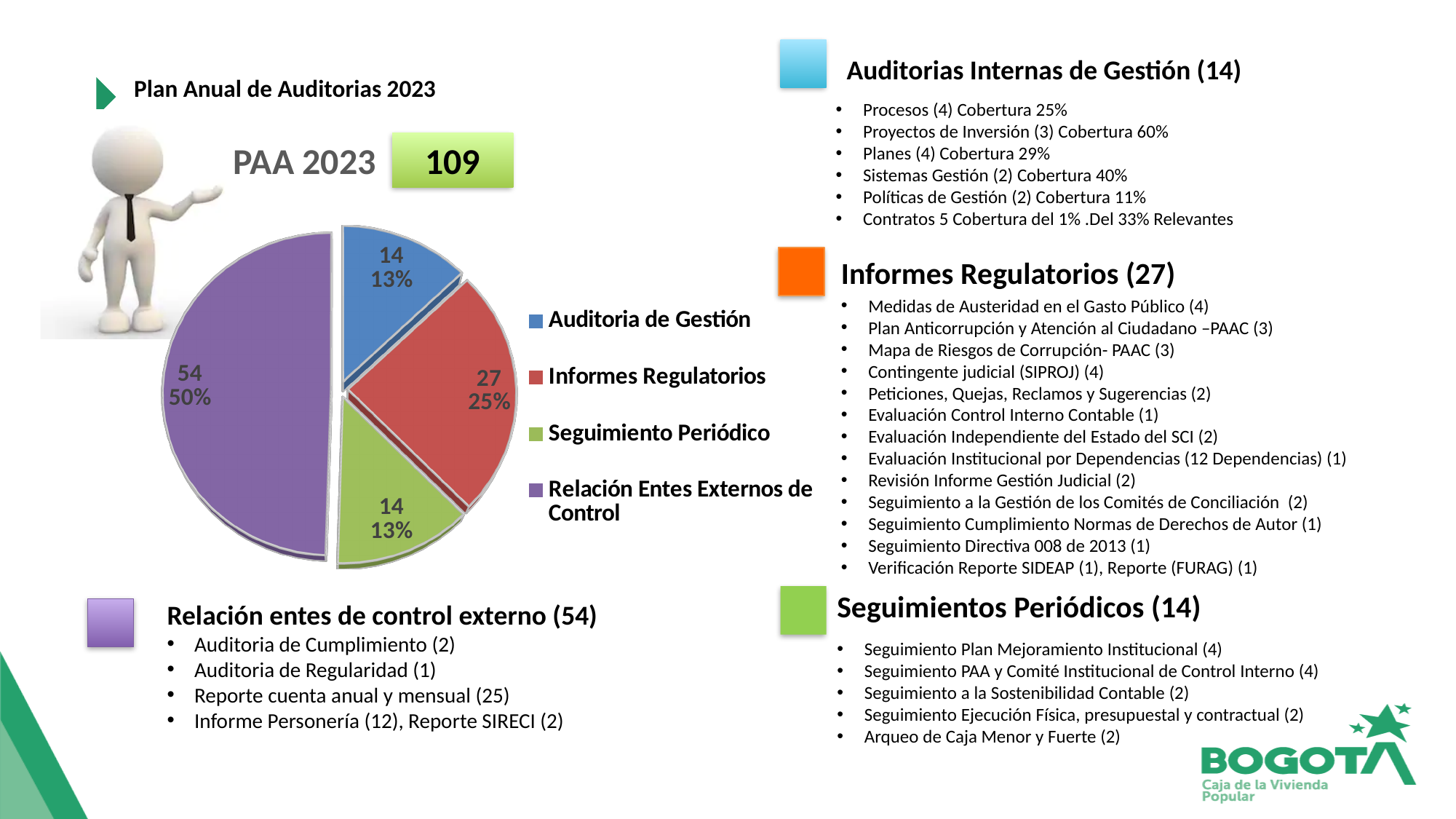
How many slices does the pie chart have? 4 What percentage share does Relación Entes Externos de Control have in the pie chart? 50% What is the title of the pie chart? PAA 2023 How many entries does the legend of the pie chart list? 4 What percentage share does Auditoria de Gestión have in the pie chart? 13% What colour is the Seguimiento Periódico slice in the pie chart? Green What is the value for Relación Entes Externos de Control in the pie chart? 54 Which category has the largest slice in the pie chart? Relación Entes Externos de Control Which is larger in the pie chart, Informes Regulatorios or Seguimiento Periódico? Informes Regulatorios What kind of chart is shown on the slide? Pie chart What is the difference between the values for Relación Entes Externos de Control and Informes Regulatorios? 27 What is the value for Informes Regulatorios in the pie chart? 27